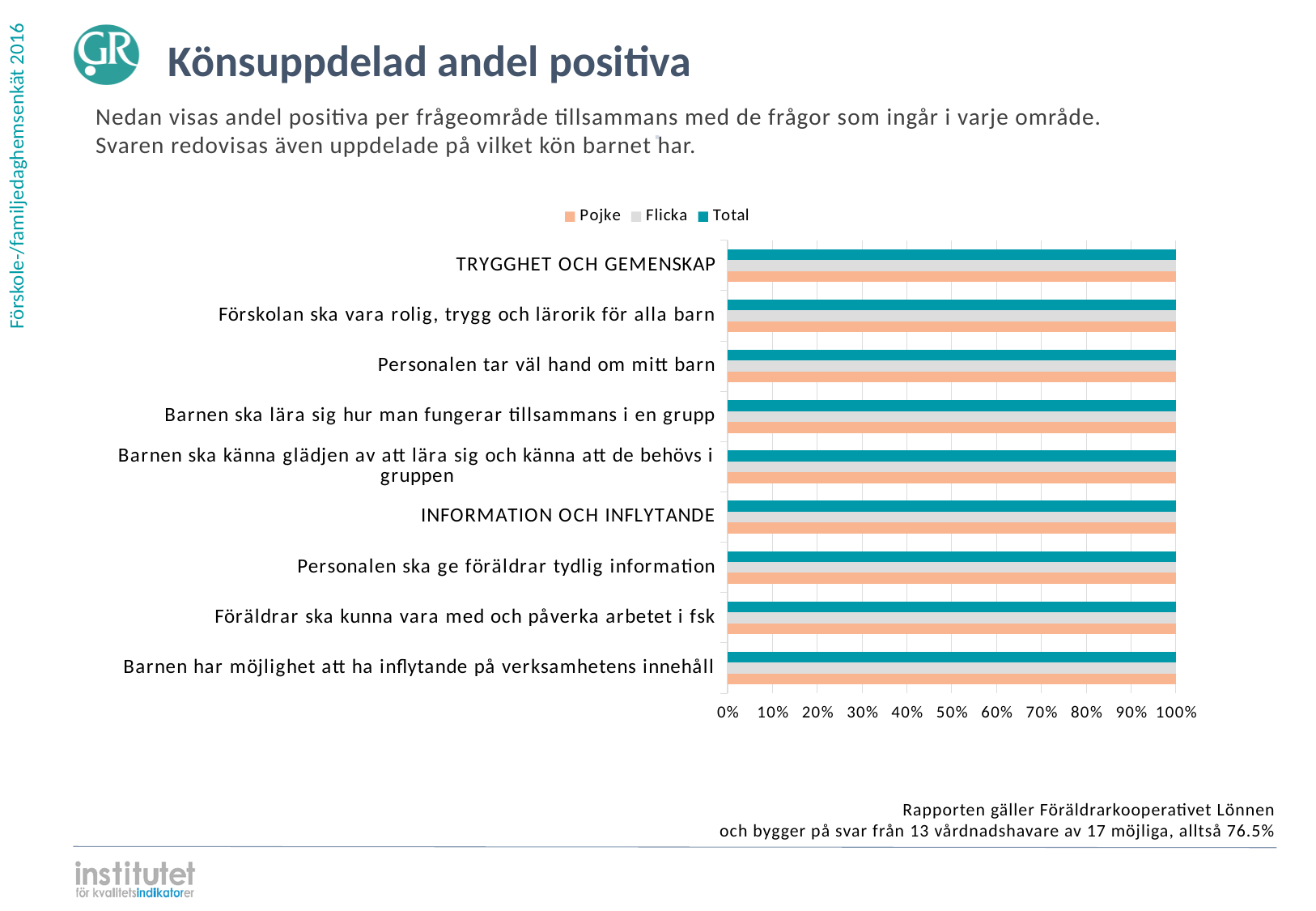
Is the Flicka value for 'Personalen tar väl hand om mitt barn' greater or less than 80%? greater What is the Pojke value for 'Föräldrar ska kunna vara med och påverka arbetet i fsk'? 100% What kind of chart is shown on the slide? bar chart Is the Total value for TRYGGHET OCH GEMENSKAP greater or less than 50%? greater Which series are listed in the legend? Pojke, Flicka, Total How many categories are shown on the vertical axis of the chart? 9 What is the title of the slide containing the chart? Könsuppdelad andel positiva What is the highest value shown on the horizontal axis? 100% How many series does the legend list? 3 Is the Pojke value for INFORMATION OCH INFLYTANDE greater or less than 90%? greater What is the Total value for 'Barnen har möjlighet att ha inflytande på verksamhetens innehåll'? 100%